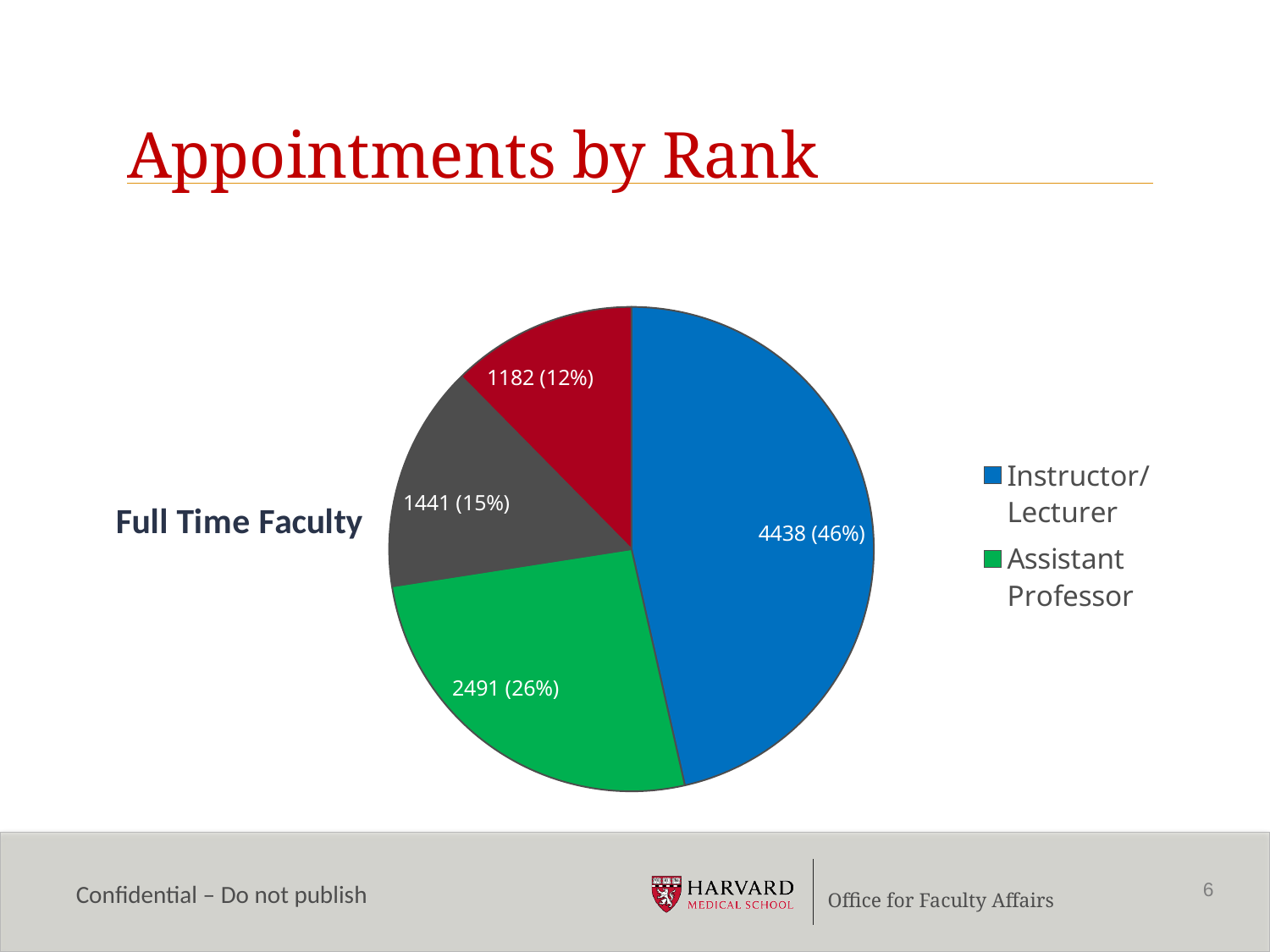
What share of the pie does Assistant Professor represent? 26% What is the difference between the Instructor/Lecturer count and the Assistant Professor count? 1947 Which legend category has the largest slice of the pie? Instructor/Lecturer What share of the pie does Instructor/Lecturer represent? 46% What value is shown for the Instructor/Lecturer slice? 4438 (46%) What value is shown for the Assistant Professor slice? 2491 (26%) Which is larger, the Instructor/Lecturer slice or the Assistant Professor slice? Instructor/Lecturer What colour is the Instructor/Lecturer slice? Blue What type of chart is shown on the slide? Pie chart What value is printed on the smallest slice of the pie? 1182 (12%) How many slices does the pie chart have? 4 How many entries does the legend list? 2